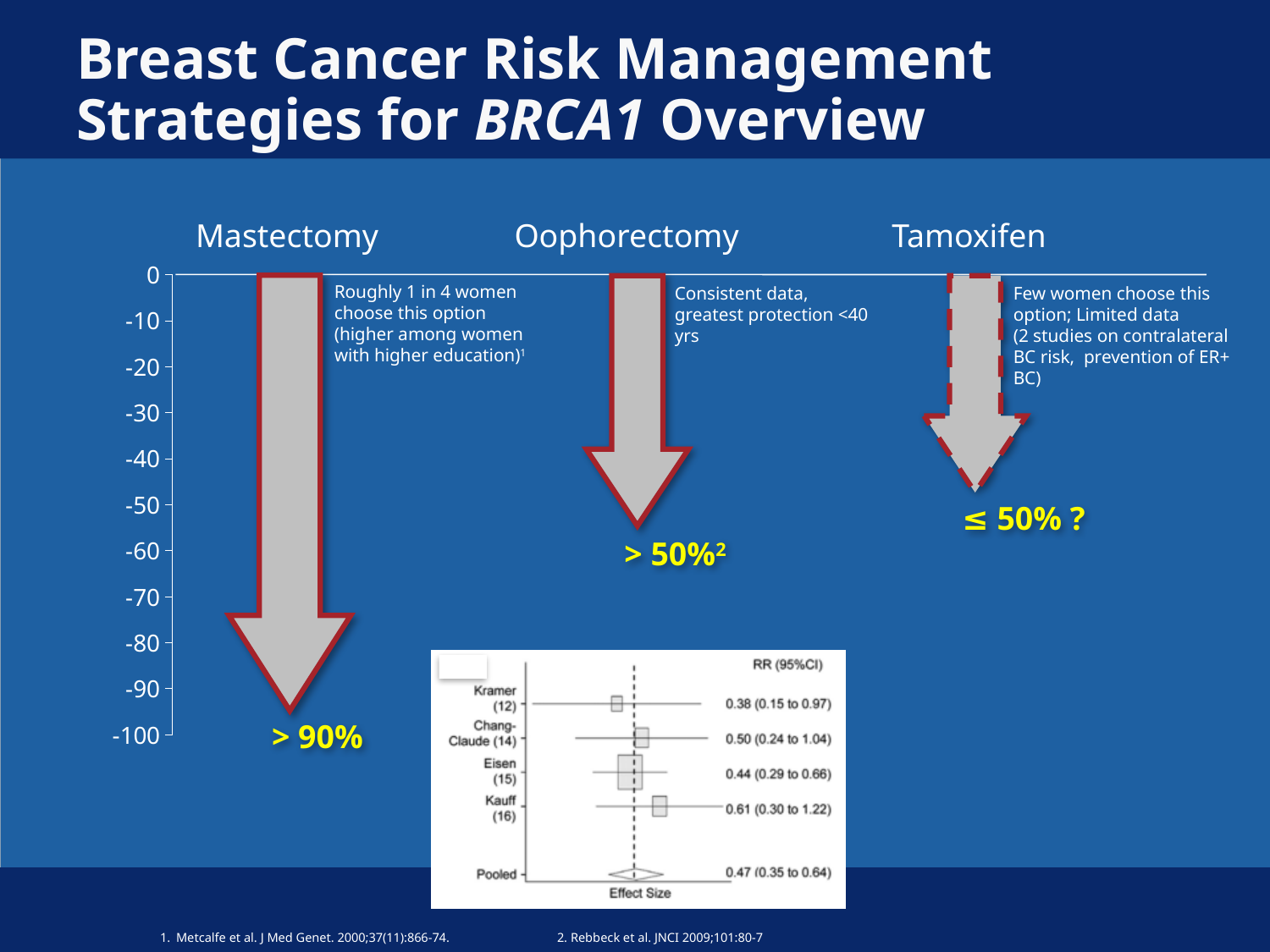
In the main arrow chart, is the axis value reached by the tip of the Mastectomy arrow greater or less than -80? less In the inset forest plot, which individual study has the highest RR point estimate? Kauff In the main arrow chart, what risk reduction label is printed under the Oophorectomy arrow? > 50% In the inset forest plot, what is the pooled RR (95% CI)? 0.47 (0.35 to 0.64) In the inset forest plot, what is the difference between the RR point estimates of Kauff and Kramer? 0.23 In the main arrow chart, which strategy's arrow extends furthest down the axis? Mastectomy In the inset forest plot, what is the RR (95% CI) for the Kramer study? 0.38 (0.15 to 0.97) In the main arrow chart, what label is printed under the Tamoxifen arrow? ≤ 50% ? In the main arrow chart, how many risk management strategies are shown along the x axis? 3 In the inset forest plot, which has the larger RR point estimate, Eisen or Chang-Claude? Chang-Claude In the main arrow chart, what is the lowest tick value shown on the vertical axis? -100 In the main arrow chart, what risk reduction label is printed under the Mastectomy arrow? > 90%